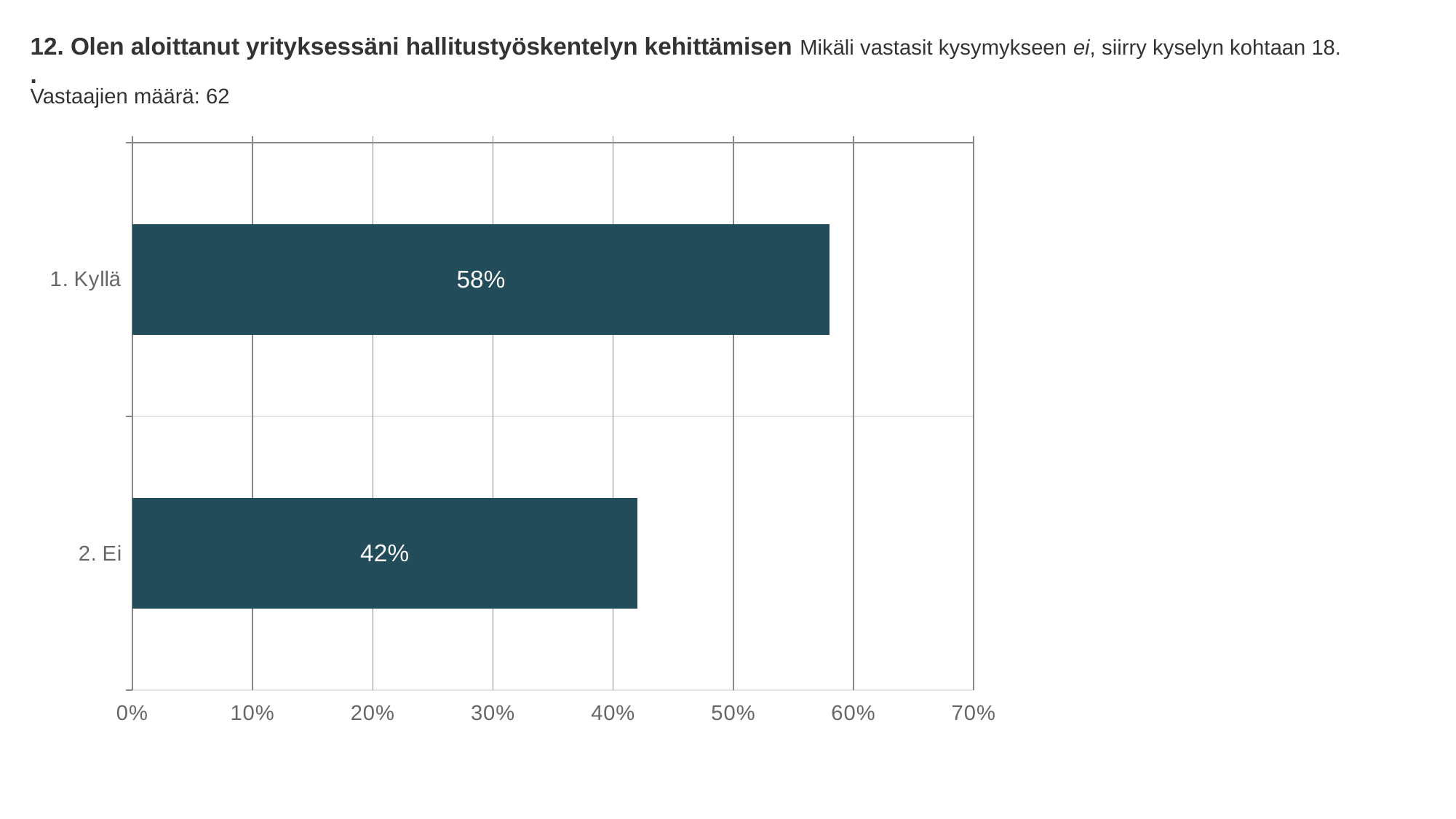
How many categories are shown in the chart? 2 Which is larger, the value for "1. Kyllä" or the value for "2. Ei"? 1. Kyllä Is the value for "2. Ei" greater or less than 50%? less Which category has the lowest value? 2. Ei What kind of chart is shown on the slide? bar chart Which category has the highest value? 1. Kyllä What is the difference between the values for "1. Kyllä" and "2. Ei"? 16% What is the number of respondents (Vastaajien määrä) stated on the slide? 62 What is the value for "1. Kyllä"? 58% What is the value for "2. Ei"? 42% Is the value for "1. Kyllä" greater or less than 50%? greater What is the highest value shown on the x axis? 70%